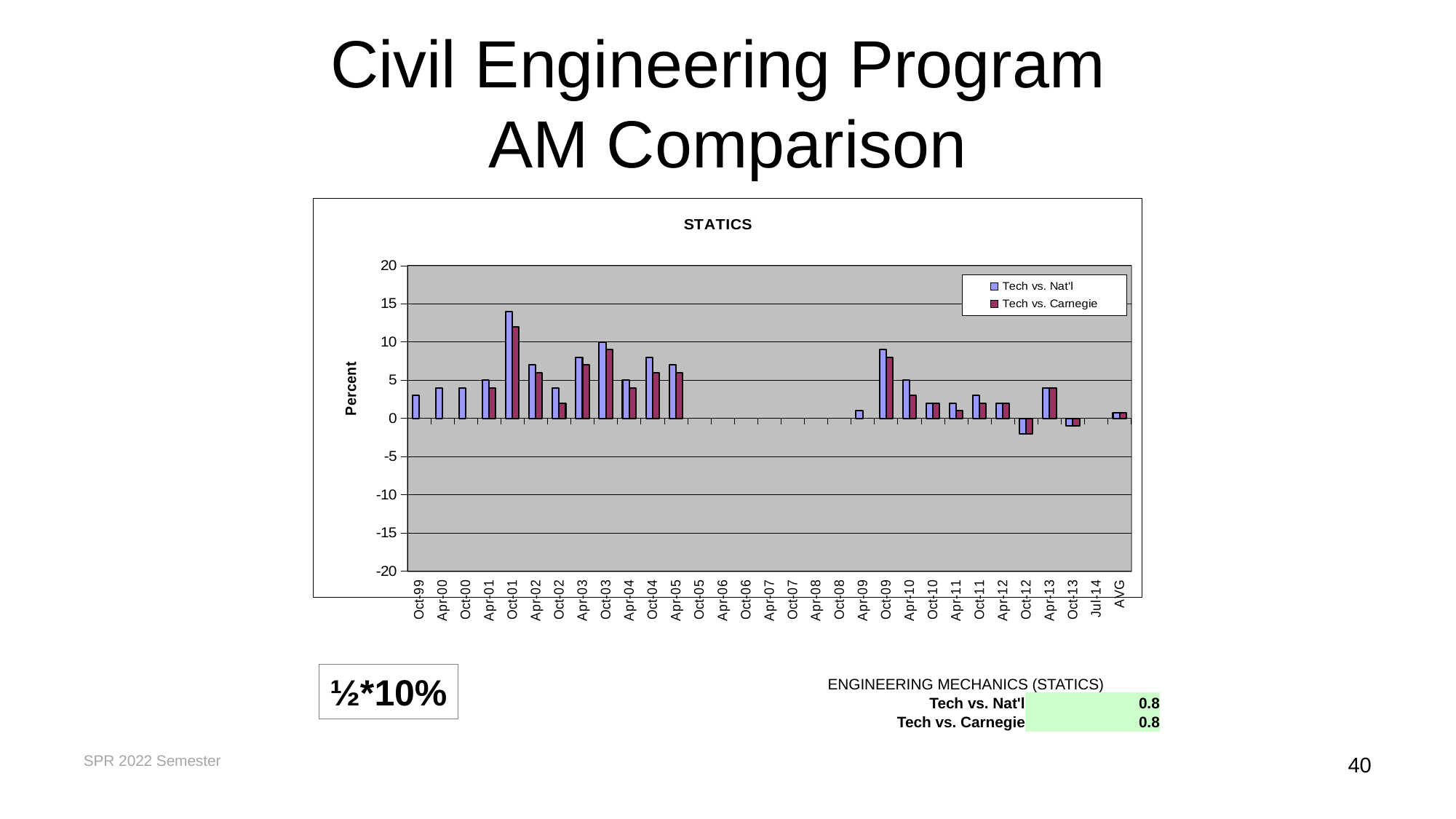
Is the Tech vs. Nat'l value for Oct-12 greater or less than 0? less How many series does the legend of the STATICS chart list? 2 Which is larger, the Tech vs. Nat'l value for Oct-01 or for Apr-02? Oct-01 Is the Tech vs. Nat'l value for Oct-01 greater or less than 10? greater What are the two series named in the legend of the STATICS chart? Tech vs. Nat'l and Tech vs. Carnegie Do the Tech vs. Nat'l values rise or fall from Oct-09 to Oct-12? fall Which category has the lowest Tech vs. Nat'l value in the STATICS chart? Oct-12 Is the Tech vs. Carnegie value for Oct-09 greater or less than 10? less What is the title of the chart? STATICS How many categories are shown on the x axis of the STATICS chart? 31 Which category has the highest Tech vs. Nat'l value in the STATICS chart? Oct-01 What kind of chart is shown on the slide? bar chart